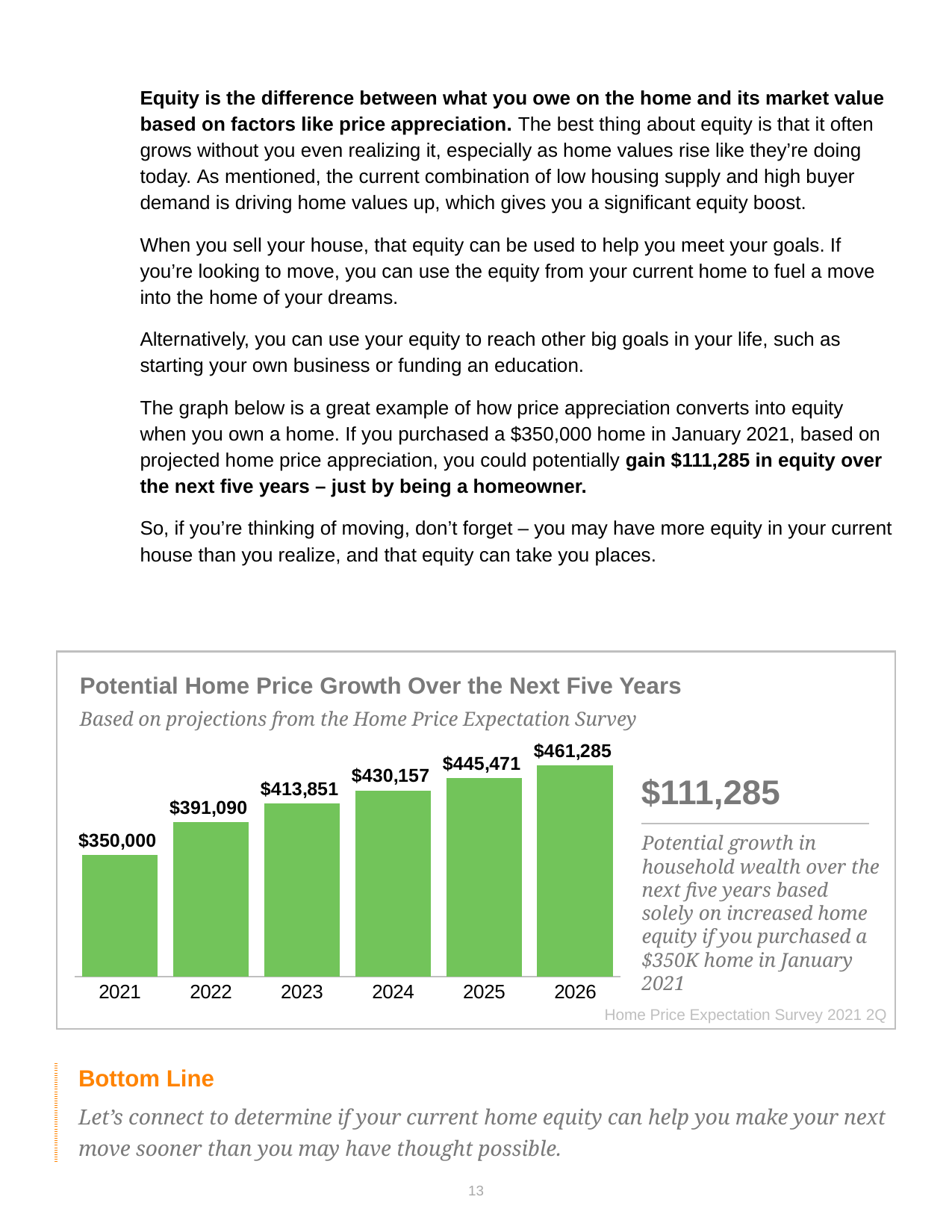
Do the home prices rise or fall from 2021 to 2026? Rise What is the projected home price for 2026? $461,285 Which is larger, the home price for 2024 or for 2025? 2025 What is the difference between the 2026 and 2021 home prices? $111,285 Which year has the highest projected home price? 2026 What is the title of the chart? Potential Home Price Growth Over the Next Five Years What is the projected home price for 2023? $413,851 What is the difference between the 2022 and 2021 home prices? $41,090 Which year has the lowest home price on the chart? 2021 What kind of chart is shown? Bar chart What is the home price shown for 2021? $350,000 How many years are shown on the chart? 6